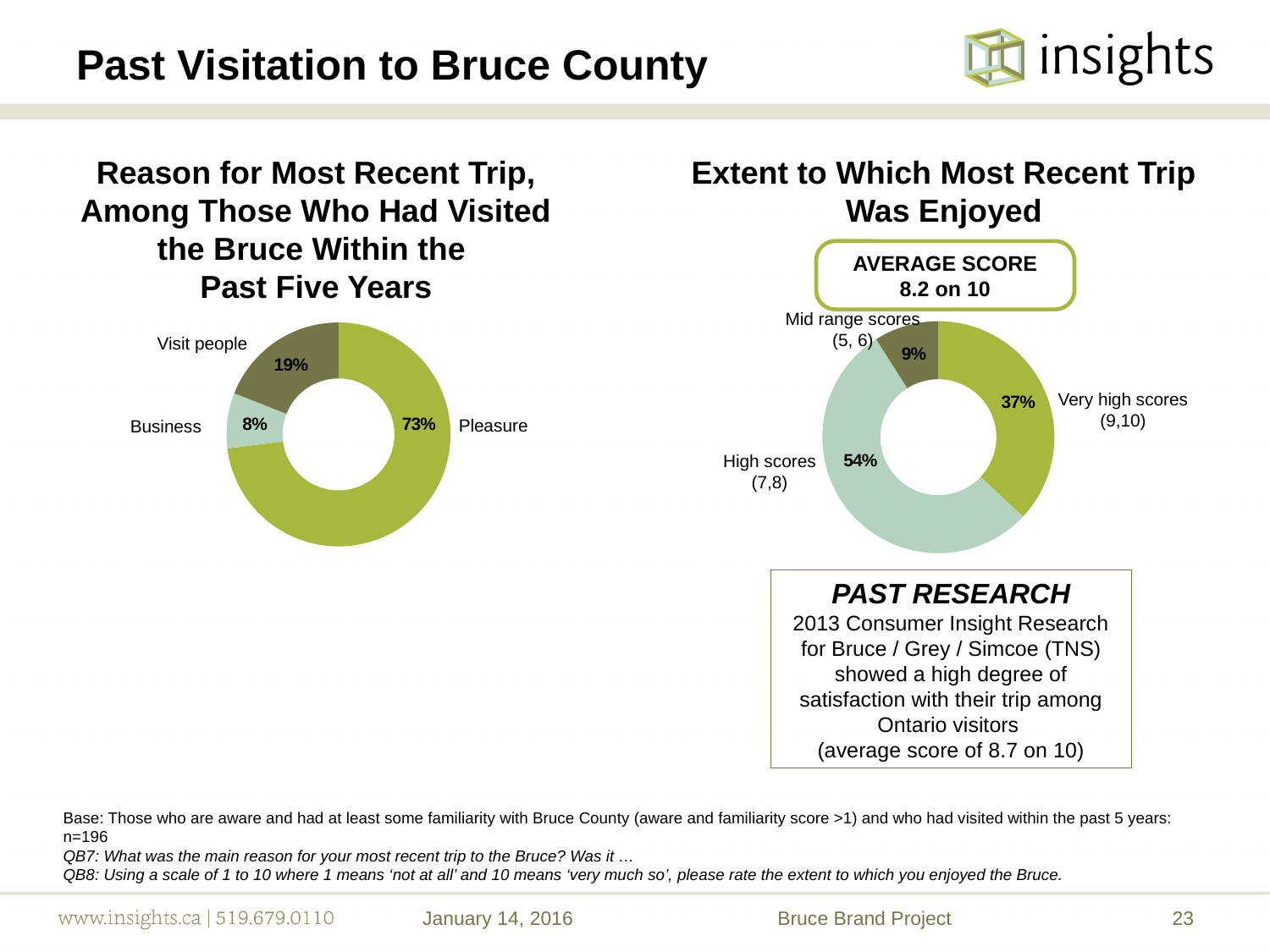
In the 'Reason for Most Recent Trip' chart, what percentage of respondents gave Pleasure as the reason? 73% In the 'Reason for Most Recent Trip' chart, how many reason categories are shown? 3 In the 'Extent to Which Most Recent Trip Was Enjoyed' chart, which is larger: Very high scores (9,10) or High scores (7,8)? High scores (7,8) What average score is shown in the box above the 'Extent to Which Most Recent Trip Was Enjoyed' chart? 8.2 on 10 In the 'Extent to Which Most Recent Trip Was Enjoyed' chart, what percentage gave Mid range scores (5, 6)? 9% In the 'Reason for Most Recent Trip' chart, what percentage of respondents gave Business as the reason? 8% In the 'Reason for Most Recent Trip' chart, what is the difference in percentage points between Pleasure and Visit people? 54 In the 'Extent to Which Most Recent Trip Was Enjoyed' chart, what percentage gave High scores (7,8)? 54% What kind of chart is used for 'Extent to Which Most Recent Trip Was Enjoyed'? Doughnut chart In the 'Extent to Which Most Recent Trip Was Enjoyed' chart, what is the difference in percentage points between High scores (7,8) and Very high scores (9,10)? 17 In the 'Reason for Most Recent Trip' chart, which reason has the largest share? Pleasure In the 'Reason for Most Recent Trip' chart, which reason has the smallest share? Business